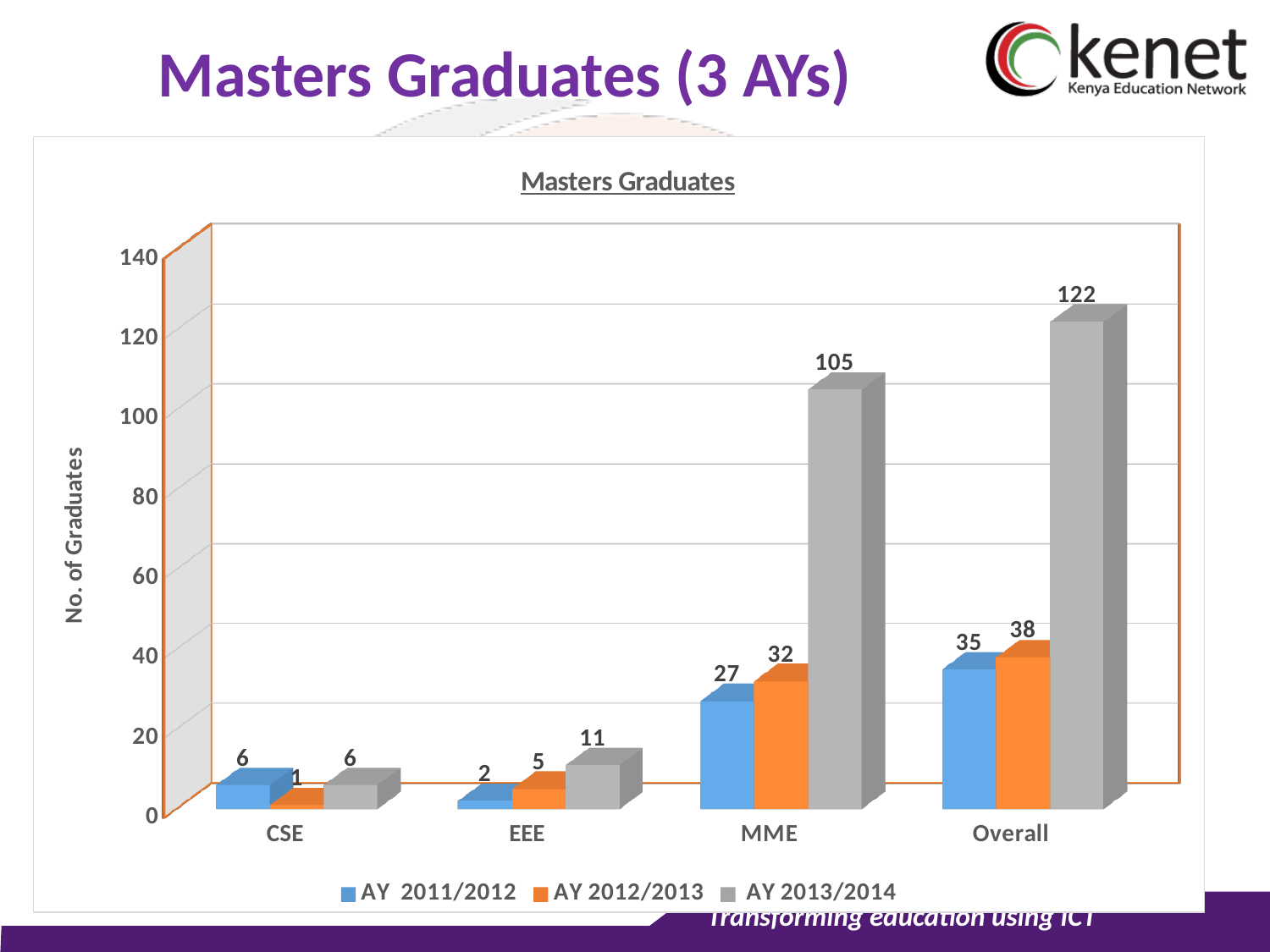
What kind of chart is shown? bar chart How many series does the legend list? 3 Is the value for MME in AY 2013/2014 greater or less than 100? greater What is the value for EEE in AY 2012/2013? 5 What is the value for MME in AY 2013/2014? 105 Which category has the lowest value in AY 2012/2013? CSE How many categories are shown on the x axis? 4 Which is larger for MME: AY 2011/2012 or AY 2012/2013? AY 2012/2013 What is the title of the chart? Masters Graduates Which category has the highest value in AY 2013/2014? Overall What is the difference between the Overall and MME values in AY 2013/2014? 17 What is the value for Overall in AY 2011/2012? 35